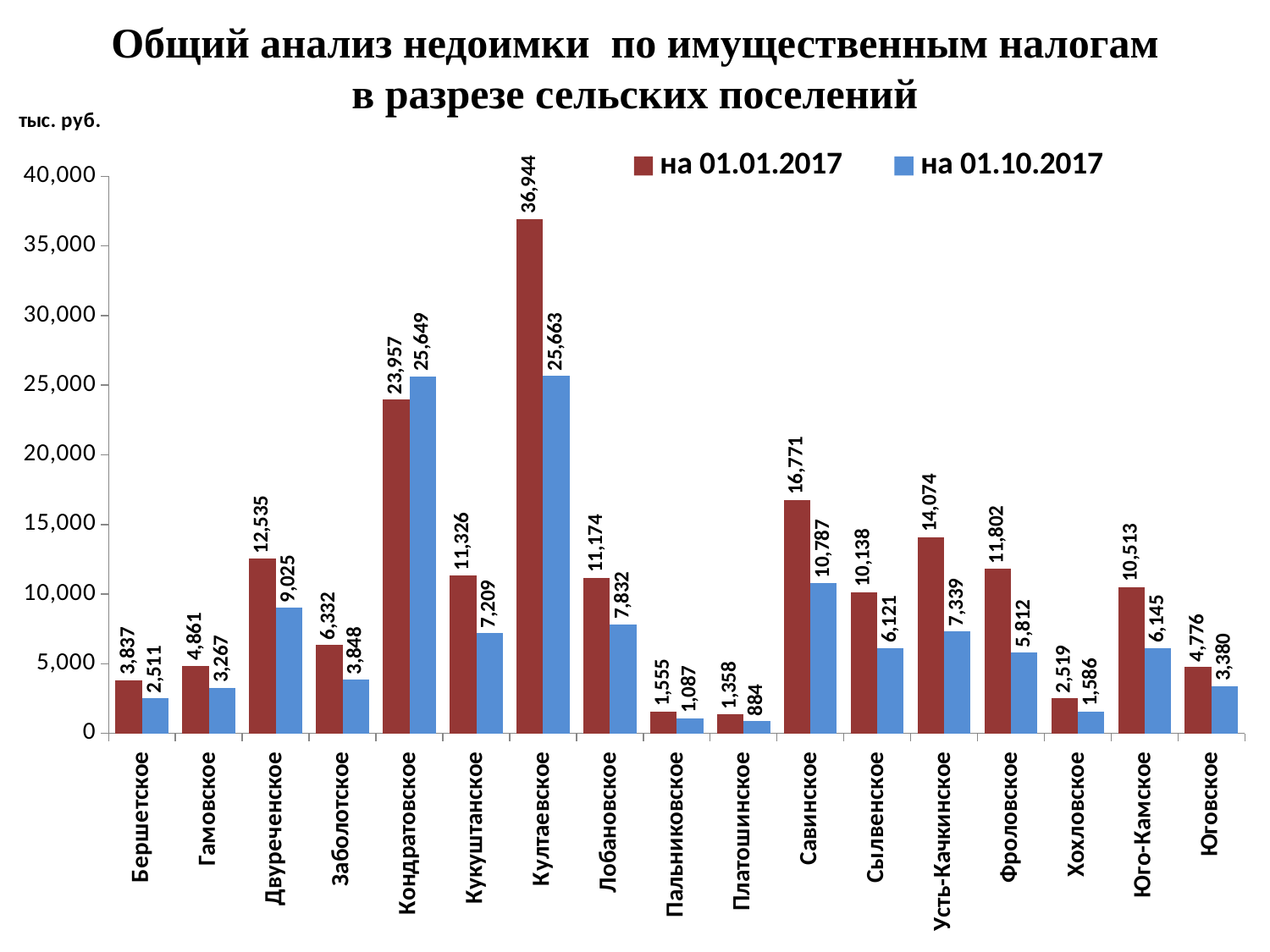
What kind of chart is shown on the slide? Bar chart Which category has the lowest value in the series "на 01.10.2017"? Платошинское Which category has the highest value in the series "на 01.01.2017"? Култаевское What is the value for Савинское in the series "на 01.01.2017"? 16,771 What unit is indicated for the values on the chart? тыс. руб. What is the difference between the "на 01.01.2017" and "на 01.10.2017" values for Двуреченское? 3,510 Which is larger for Кондратовское: the value "на 01.01.2017" or "на 01.10.2017"? на 01.10.2017 How many series does the legend list? 2 What is the value for Култаевское in the series "на 01.01.2017"? 36,944 Which is larger in the series "на 01.10.2017": Усть-Качкинское or Фроловское? Усть-Качкинское What is the value for Кондратовское in the series "на 01.10.2017"? 25,649 How many categories (settlements) are shown on the x axis? 17